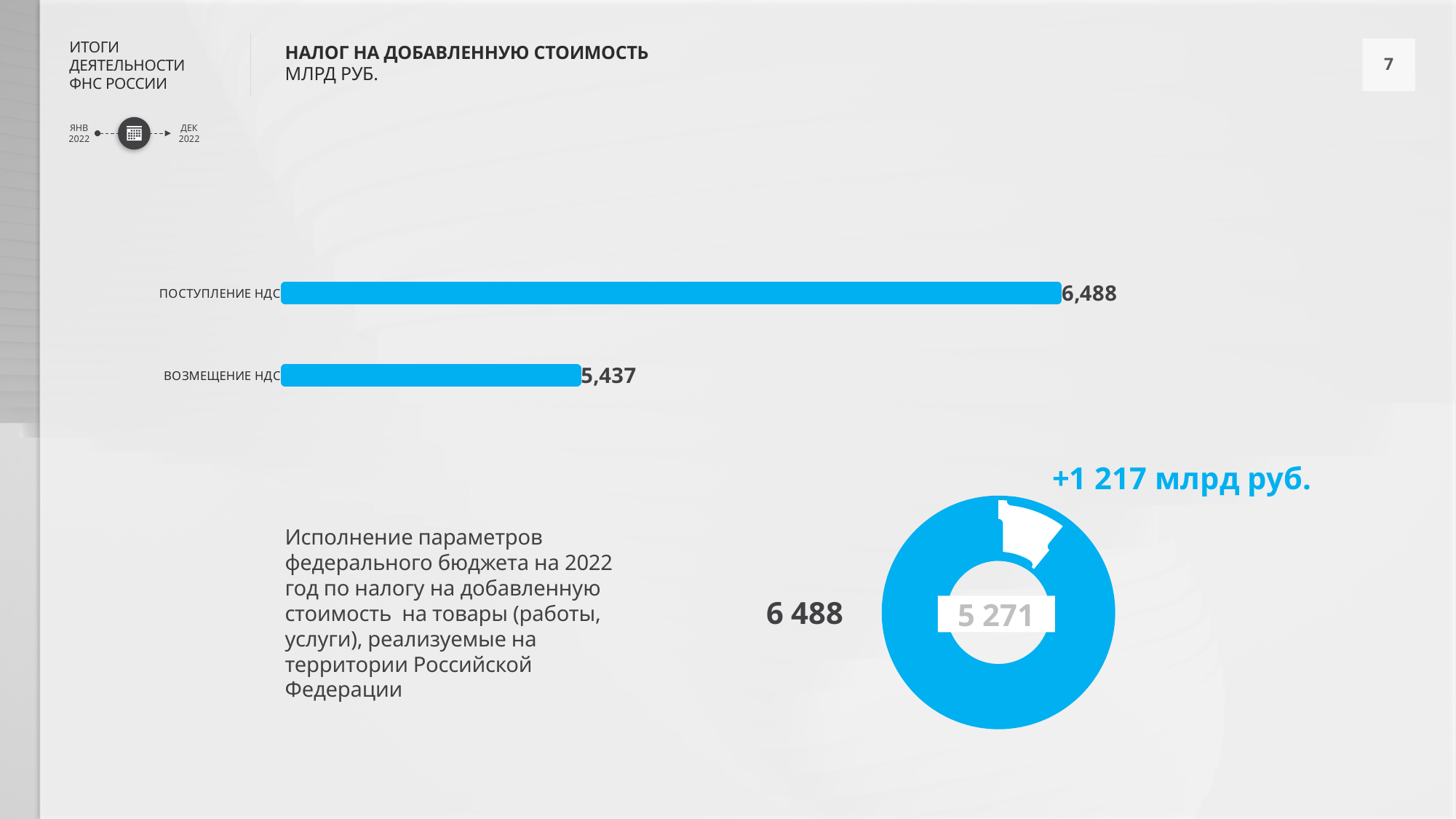
In the bar chart, which is larger: ПОСТУПЛЕНИЕ НДС or ВОЗМЕЩЕНИЕ НДС? ПОСТУПЛЕНИЕ НДС In the bar chart, what is the value for ПОСТУПЛЕНИЕ НДС? 6,488 In the donut chart at the bottom right, what value is printed to the left of the ring? 6 488 What kind of chart is the chart at the bottom right of the slide? donut chart In the bar chart, what is the difference between ПОСТУПЛЕНИЕ НДС and ВОЗМЕЩЕНИЕ НДС? 1,051 In the donut chart at the bottom right, what value is printed in the centre? 5 271 What kind of chart is the chart at the top of the slide? bar chart In the bar chart, what is the value for ВОЗМЕЩЕНИЕ НДС? 5,437 In the bar chart, which category has the lowest value? ВОЗМЕЩЕНИЕ НДС What is the title of the bar chart at the top of the slide? НАЛОГ НА ДОБАВЛЕННУЮ СТОИМОСТЬ In the bar chart, which category has the highest value? ПОСТУПЛЕНИЕ НДС How many categories does the bar chart show? 2